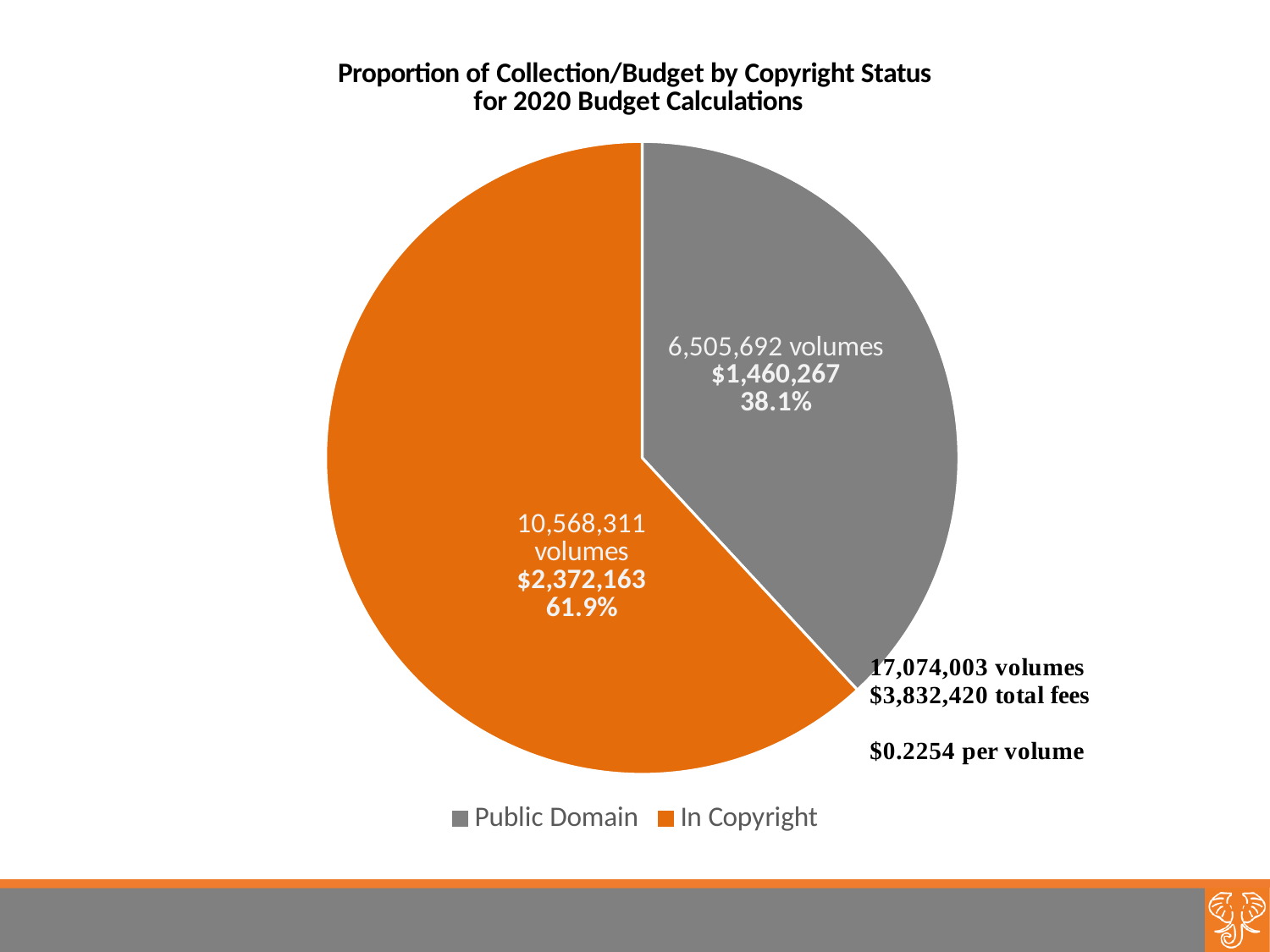
What is the title of the chart? Proportion of Collection/Budget by Copyright Status for 2020 Budget Calculations What kind of chart is shown on the slide? pie chart How many slices does the pie chart have? 2 How many volumes are labelled for the Public Domain slice? 6,505,692 volumes Which slice is larger, Public Domain or In Copyright? In Copyright What percentage share of the pie is In Copyright? 61.9% How many entries does the legend list? 2 What dollar amount is labelled on the Public Domain slice? $1,460,267 What dollar amount is labelled on the In Copyright slice? $2,372,163 What percentage share of the pie is Public Domain? 38.1% What is the difference in percentage points between the In Copyright and Public Domain shares? 23.8 percentage points How many volumes are labelled for the In Copyright slice? 10,568,311 volumes